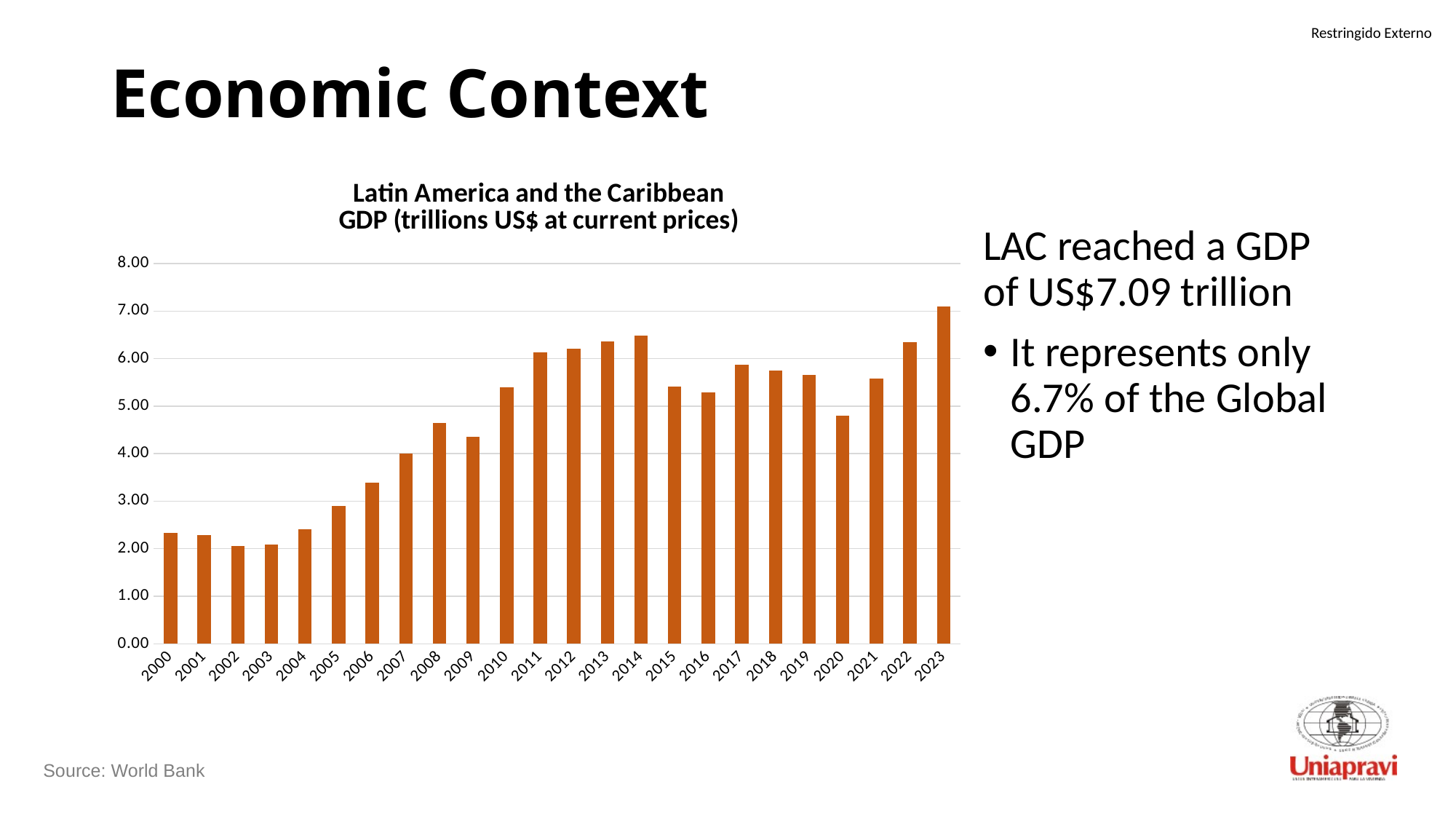
What kind of chart is shown on the slide? Bar chart Is the GDP value for 2008 greater or less than 4.00? greater Is the GDP value for 2014 greater or less than 6.00? greater Is the GDP value for 2005 greater or less than 3.00? less Which year has the highest GDP value in the chart? 2023 Overall, do the GDP values rise or fall from 2000 to 2023? Rise What is the title of the chart? Latin America and the Caribbean GDP (trillions US$ at current prices) Which year has the larger GDP value, 2014 or 2015? 2014 How many years are plotted on the x axis of the chart? 24 Which year has the larger GDP value, 2019 or 2020? 2019